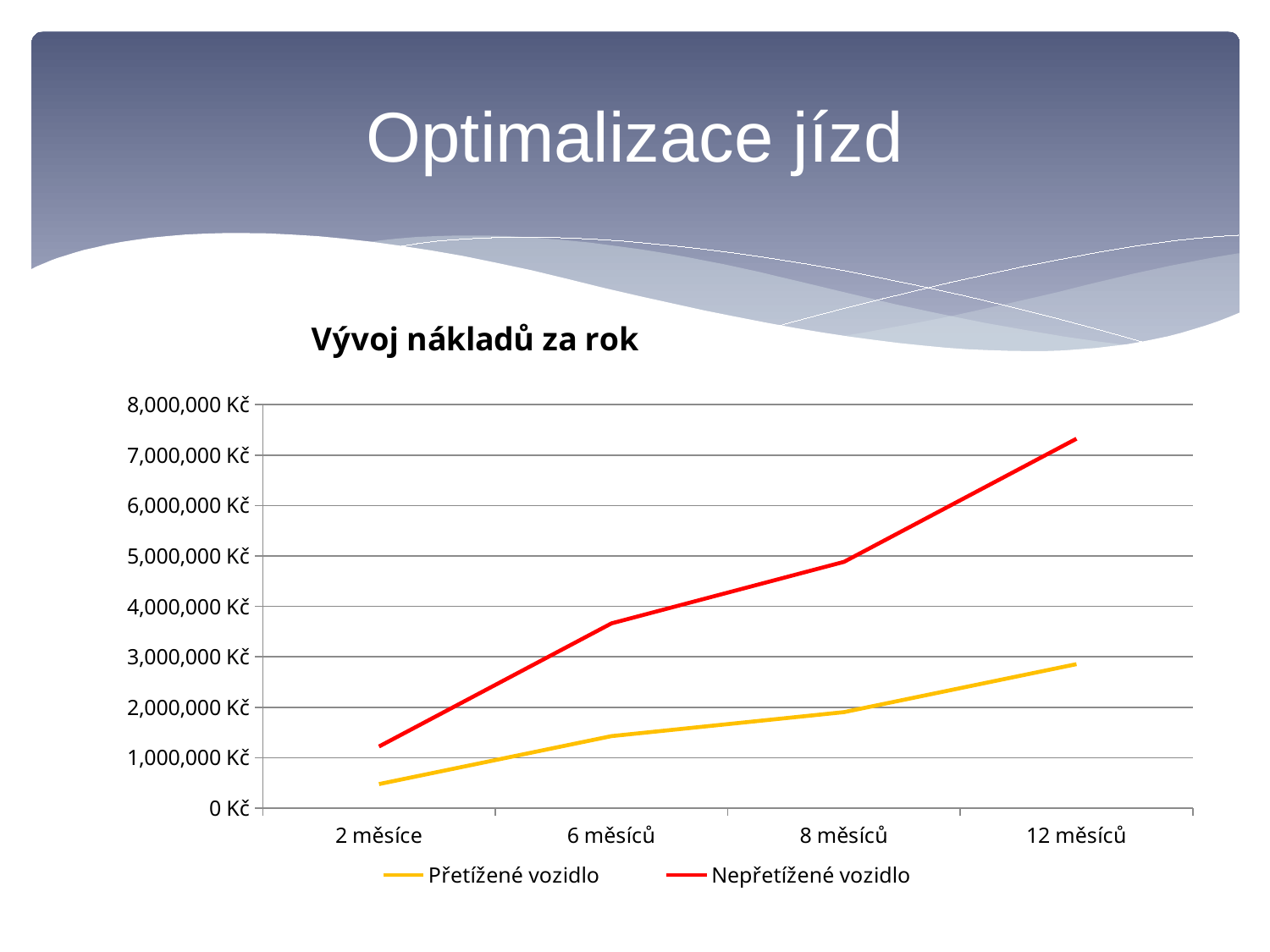
Do the values for Nepřetížené vozidlo rise or fall from 2 měsíce to 12 měsíců? Rise At which category is the value for Nepřetížené vozidlo highest? 12 měsíců What type of chart is shown on the slide? Line chart At which category is the value for Přetížené vozidlo lowest? 2 měsíce What is the title of the chart? Vývoj nákladů za rok At 12 měsíců, which series has the higher value, Přetížené vozidlo or Nepřetížené vozidlo? Nepřetížené vozidlo Which series is shown in red? Nepřetížené vozidlo How many categories are shown on the x axis? 4 Is the value for Nepřetížené vozidlo at 12 měsíců greater or less than 7,000,000 Kč? greater Is the value for Nepřetížené vozidlo at 6 měsíců greater or less than 3,000,000 Kč? greater Is the value for Přetížené vozidlo at 2 měsíce greater or less than 1,000,000 Kč? less How many series does the legend list? 2